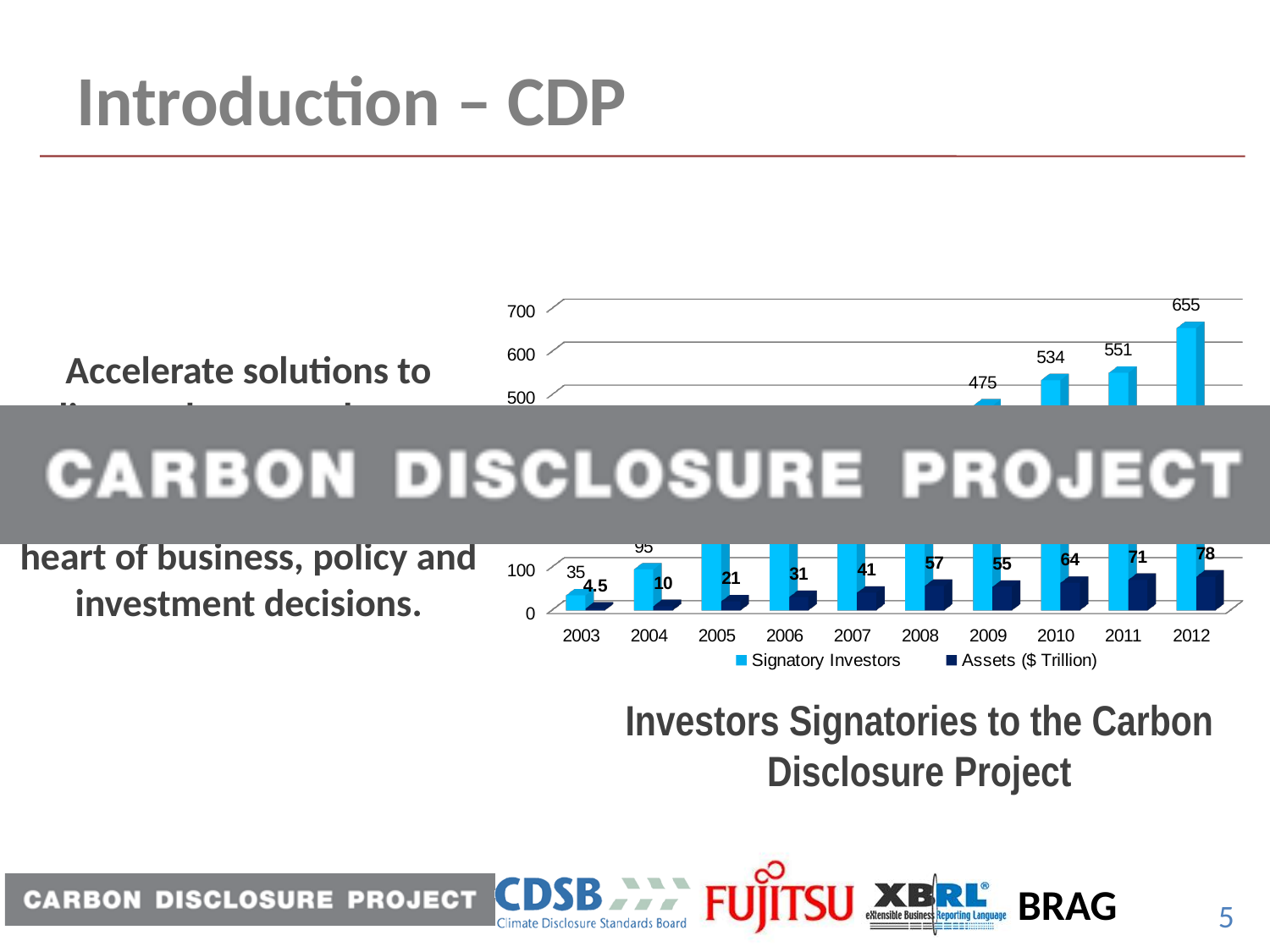
What is the difference between Signatory Investors in 2012 and 2011? 104 How many years are shown on the x axis? 10 What is the value for Signatory Investors in 2012? 655 Which year has the highest value for Signatory Investors? 2012 What is the value for Assets ($ Trillion) in 2010? 64 What is the title shown below the chart? Investors Signatories to the Carbon Disclosure Project What kind of chart is shown? Bar chart Which is larger, Assets ($ Trillion) in 2008 or in 2009? 2008 Which year has the lowest value for Assets ($ Trillion)? 2003 What is the value for Assets ($ Trillion) in 2003? 4.5 What is the value for Signatory Investors in 2009? 475 How many series does the legend list? 2